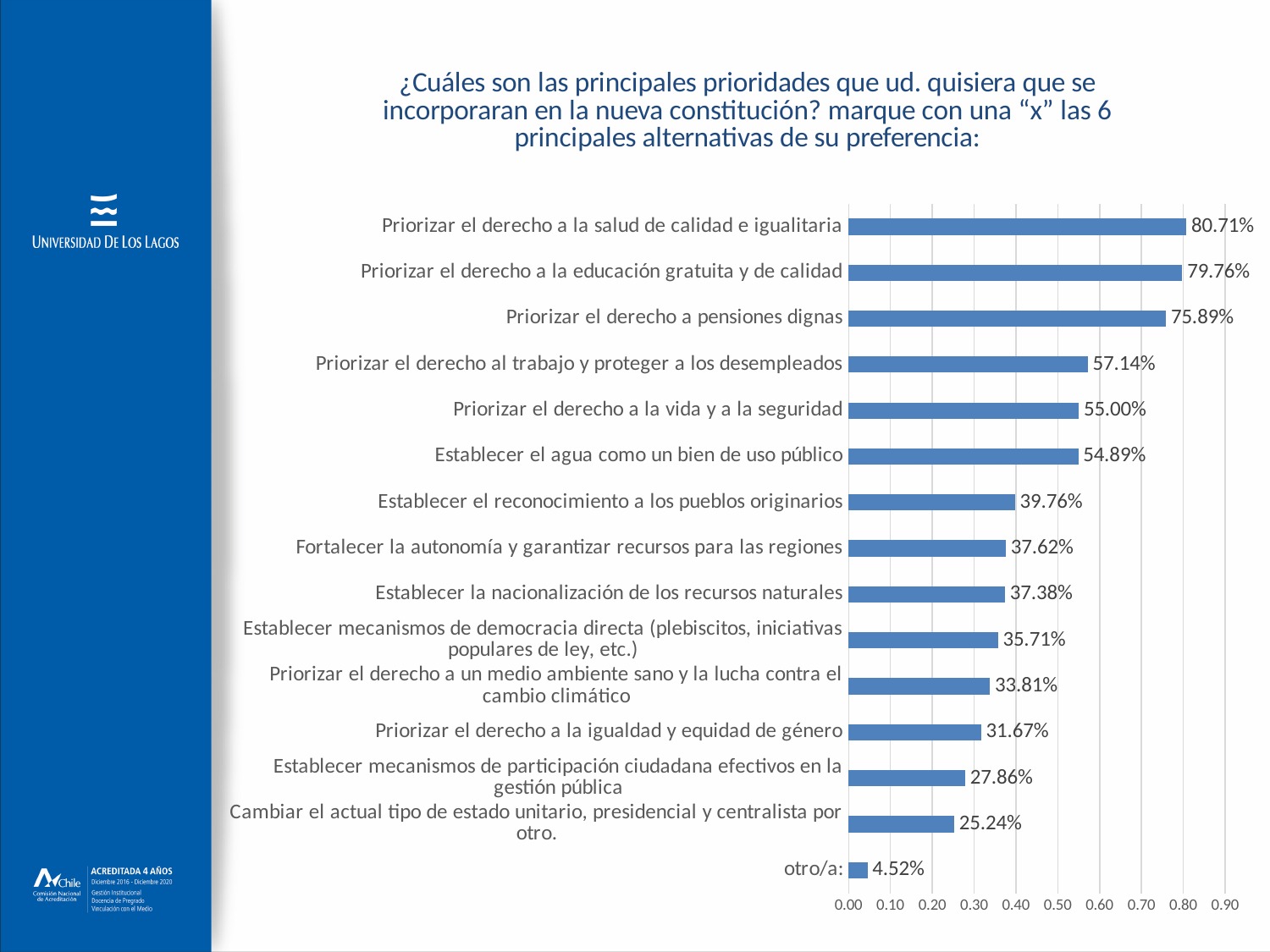
What is the value for "Priorizar el derecho a la salud de calidad e igualitaria"? 80.71% What is the value for "Priorizar el derecho a la igualdad y equidad de género"? 31.67% How many categories are shown in the chart? 15 What is the difference between the values for "Priorizar el derecho a la salud de calidad e igualitaria" and "Priorizar el derecho a la educación gratuita y de calidad"? 0.95% What kind of chart is shown on the slide? bar chart What is the difference between the values for "Priorizar el derecho al trabajo y proteger a los desempleados" and "Priorizar el derecho a la vida y a la seguridad"? 2.14% Is the value for "Priorizar el derecho a pensiones dignas" greater or less than 0.70? greater Which category has the lowest value? otro/a What is the value for "otro/a"? 4.52% Which is larger: the value for "Establecer el reconocimiento a los pueblos originarios" or the value for "Cambiar el actual tipo de estado unitario, presidencial y centralista por otro."? Establecer el reconocimiento a los pueblos originarios What is the value for "Establecer el agua como un bien de uso público"? 54.89% Which category has the highest value? Priorizar el derecho a la salud de calidad e igualitaria